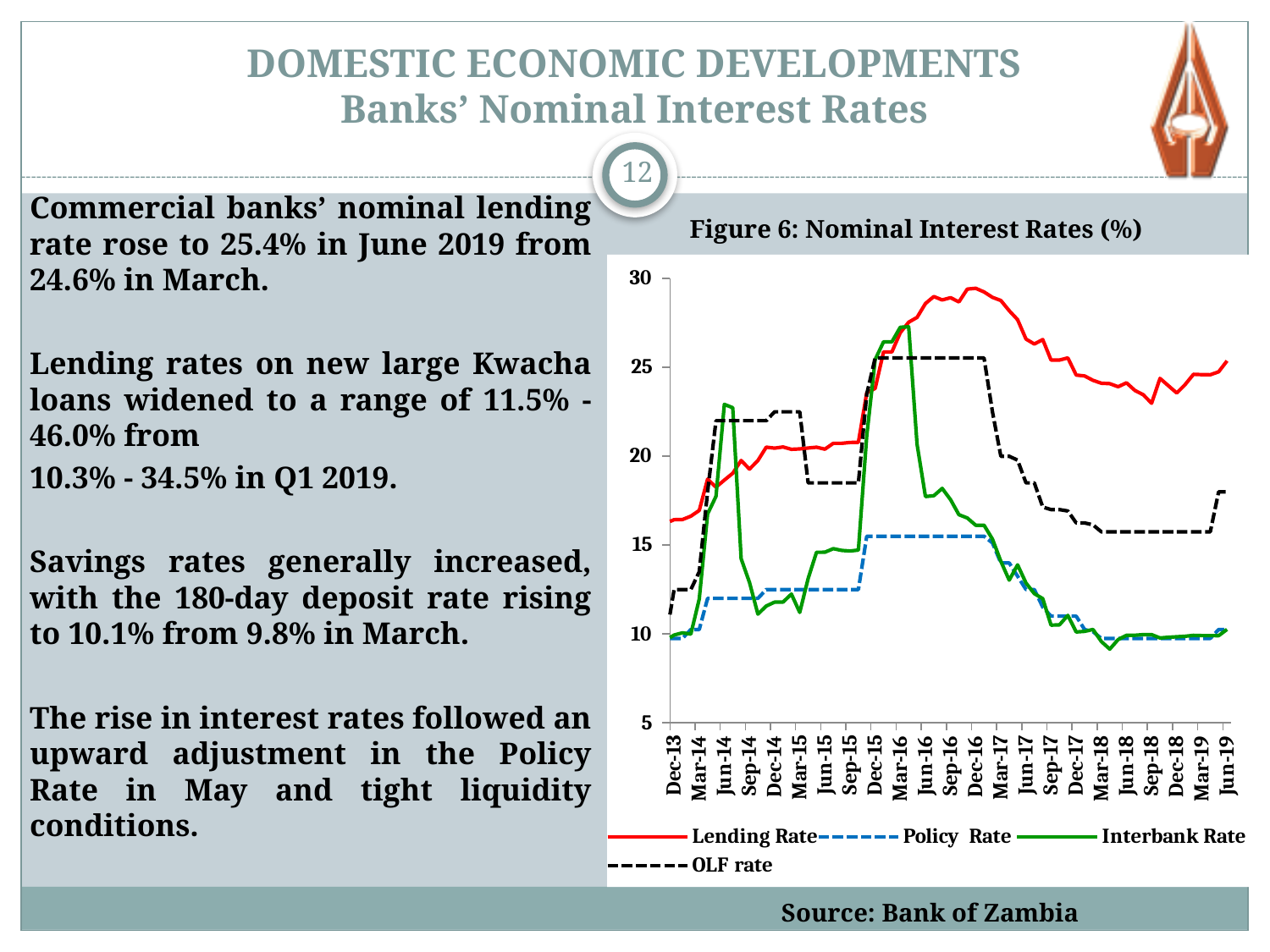
Is the Policy Rate at Jun-19 greater or less than 15? less Is the Lending Rate at Dec-16 greater or less than 25? greater Is the OLF rate at Jun-19 greater or less than 20? less How many series does the legend of Figure 6 list? 4 Does the Policy Rate rise or fall between Dec-16 and Mar-18? fall Which series has the highest value at Jun-19? Lending Rate What kind of chart is Figure 6? line chart How many date labels are shown on the x axis of Figure 6? 23 At Jun-19, which is higher, the Lending Rate or the Policy Rate? Lending Rate What is the title of the chart on the slide? Figure 6: Nominal Interest Rates (%)